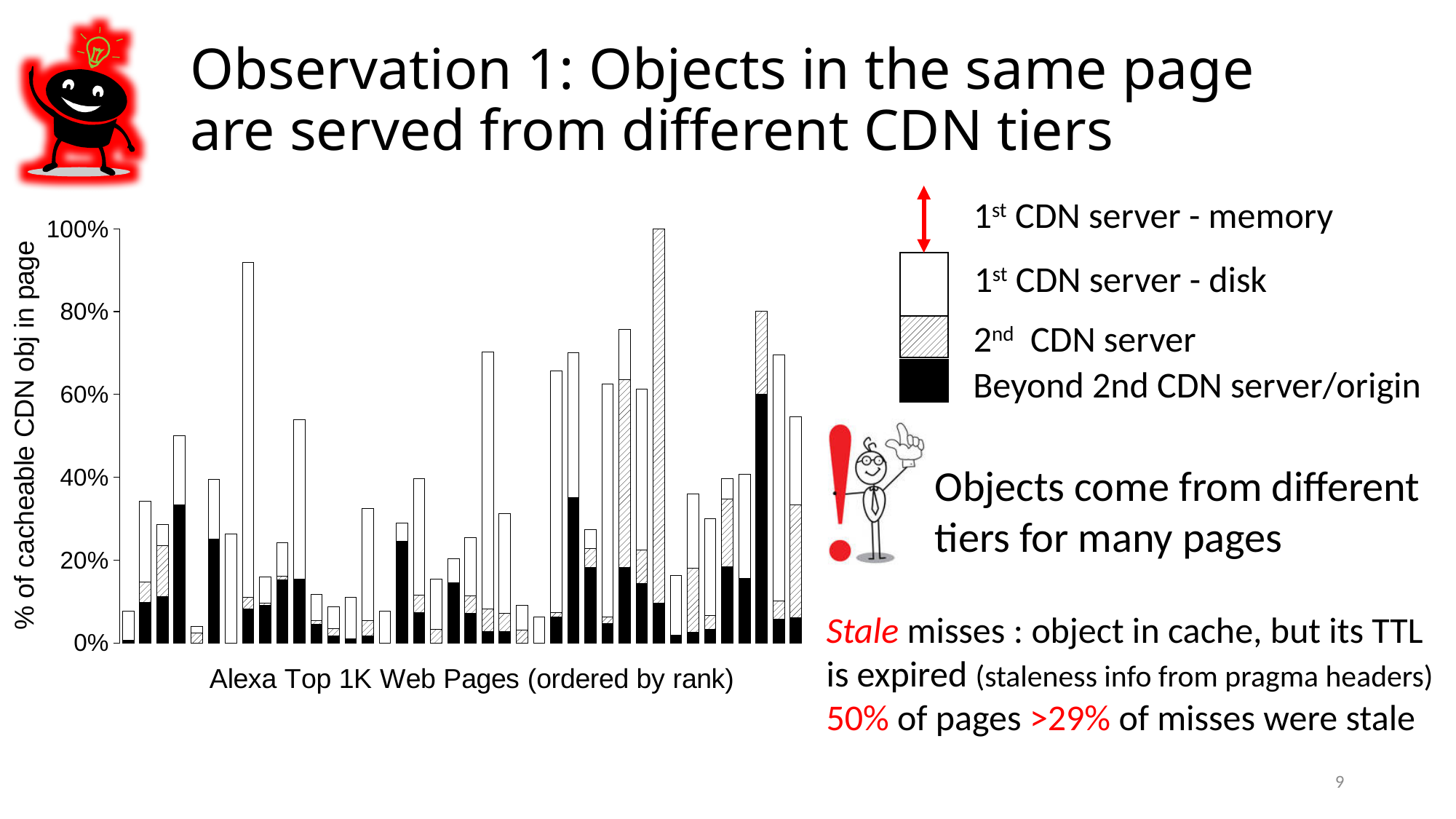
Which legend entry is drawn as a solid black segment? Beyond 2nd CDN server/origin What is the highest tick value shown on the y axis? 100% Do the bar totals rise steadily, fall steadily, or fluctuate along the x axis? fluctuate Is the total of the leftmost bar greater or less than 20%? less How many entries does the chart's legend list? 4 What is the label on the y axis of the chart? % of cacheable CDN obj in page What total value does the tallest bar in the chart reach? 100% What kind of chart is shown on the slide? Stacked bar chart Is the total of the tallest bar greater or less than 80%? greater